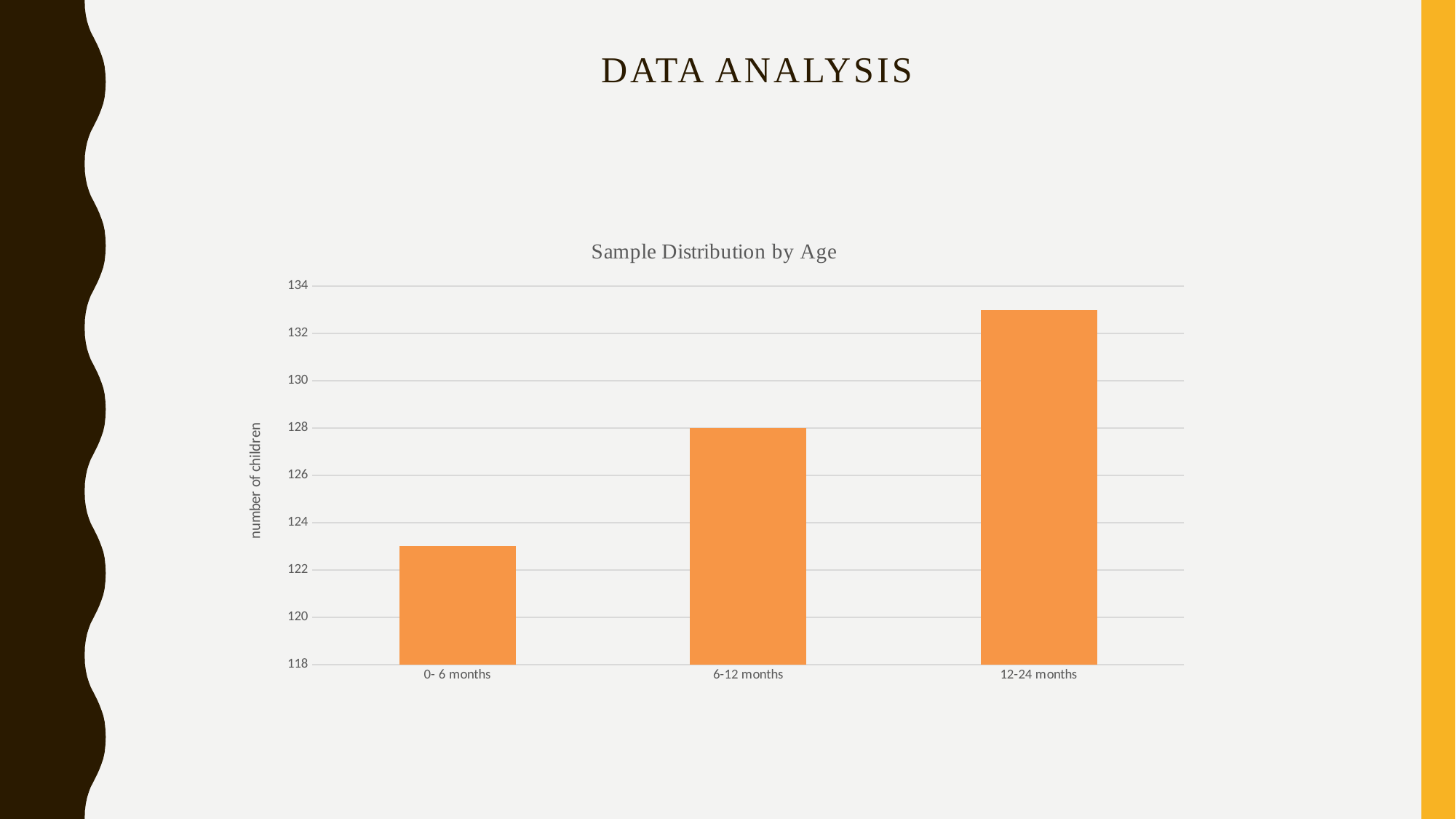
Which age category has the highest number of children? 12-24 months Which age category has the lowest number of children? 0- 6 months Is the value for 0- 6 months greater or less than 122? greater What is the title of the chart? Sample Distribution by Age What is the label on the vertical axis of the chart? number of children What type of chart is shown on the slide? bar chart How many age categories are shown in the chart? 3 Is the value for 0- 6 months greater or less than 124? less Do the values rise or fall as the age categories move from left to right along the x axis? rise What is the number of children for the 6-12 months category? 128 Which has more children, the 6-12 months category or the 12-24 months category? 12-24 months Is the value for 12-24 months greater or less than 132? greater